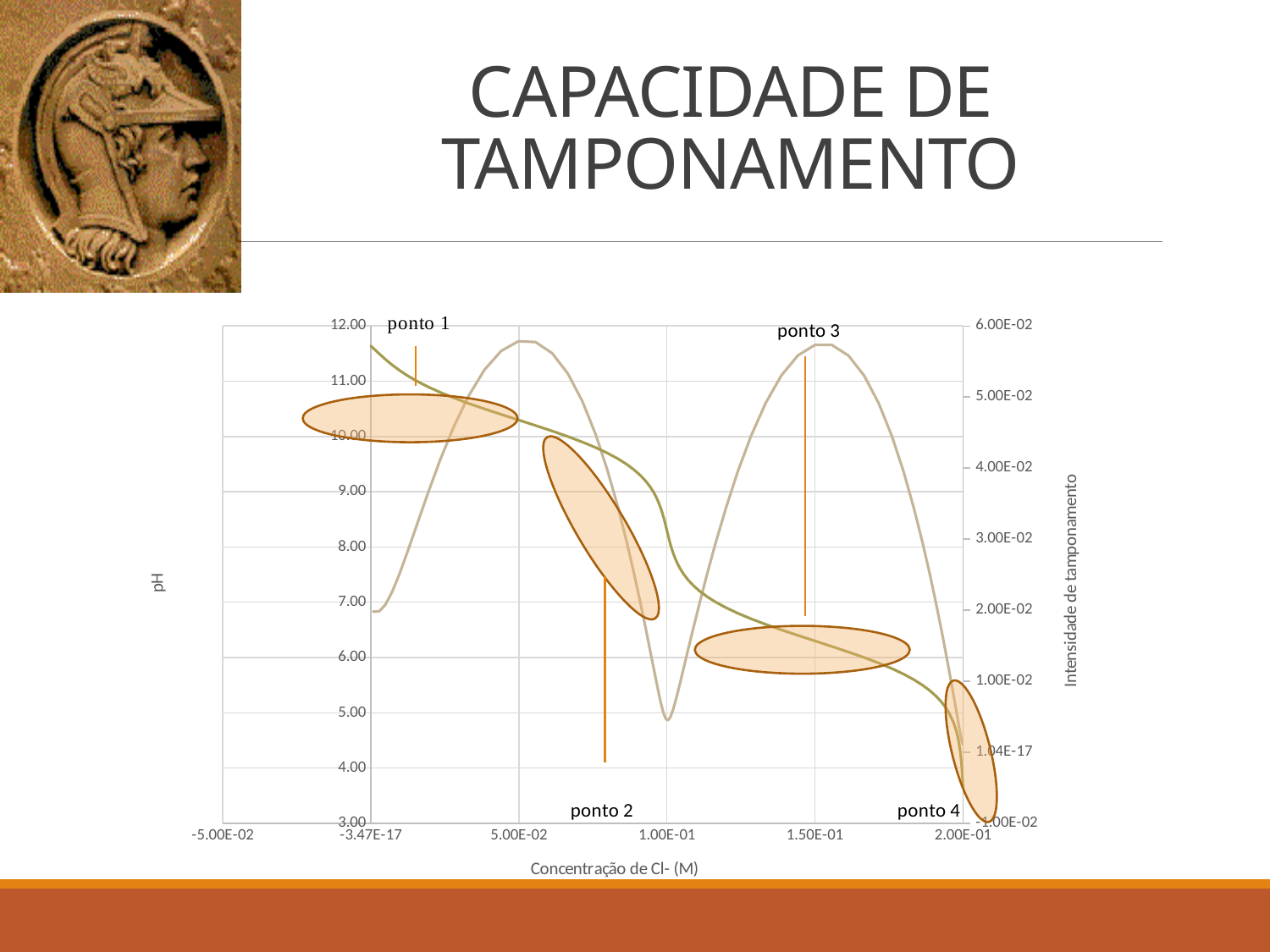
What is the title of the right-hand vertical axis of the chart? Intensidade de tamponamento Is the pH value at a Cl- concentration of 2.00E-01 greater or less than 5.00? less Is the pH value at a Cl- concentration of 1.00E-01 greater or less than 6.00? greater What is the title of the x axis of the chart? Concentração de Cl- (M) Does the pH series rise or fall as the concentration of Cl- increases along the x axis? fall How many labelled points ("ponto") are annotated on the chart? 4 What kind of chart is shown on the slide? line chart Is the pH value at a Cl- concentration of -3.47E-17 greater or less than 11.00? greater